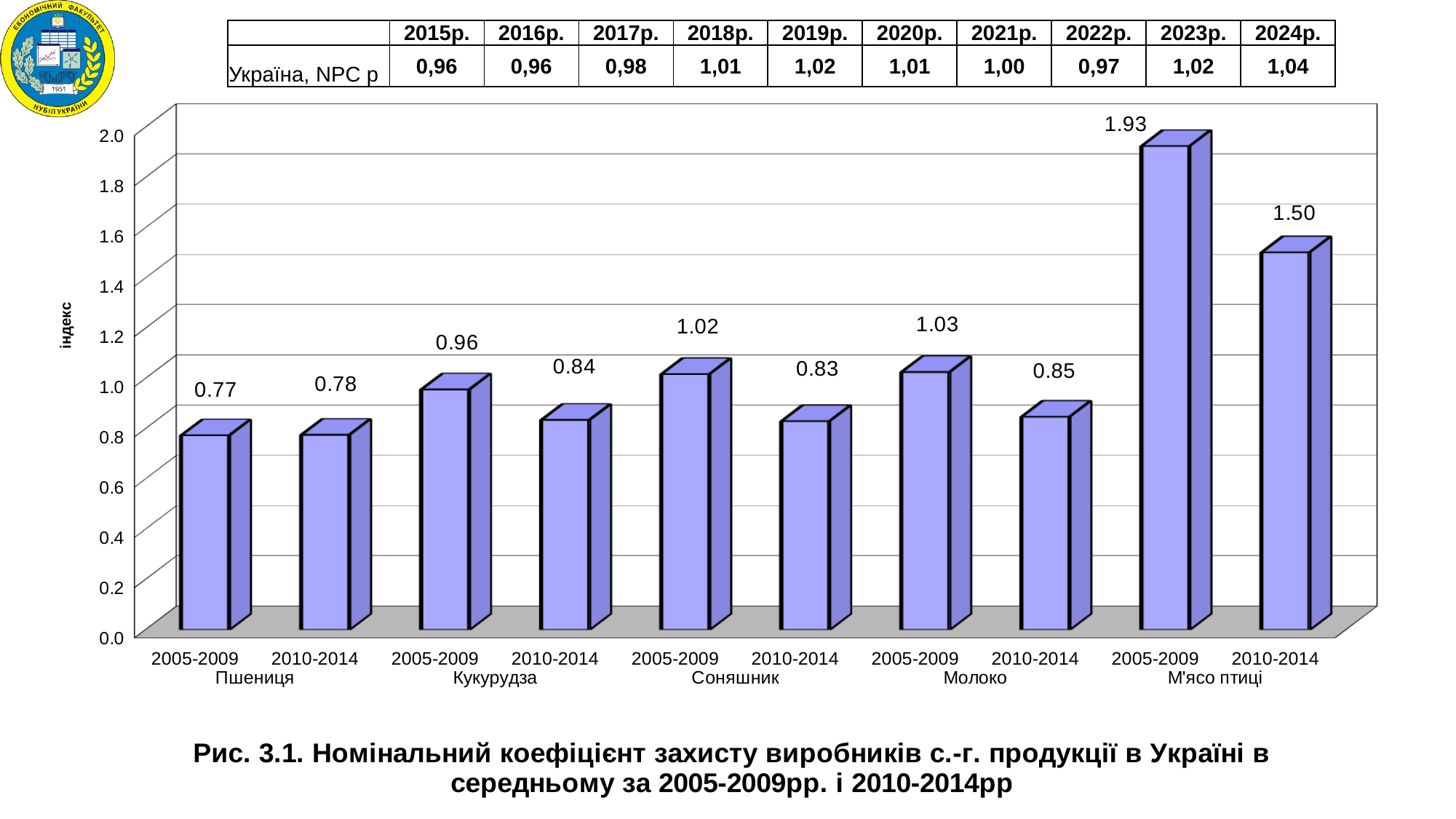
What is the difference between the М'ясо птиці values for 2005-2009 and 2010-2014? 0.43 Which bar has the highest value? М'ясо птиці 2005-2009 What is the value for Пшениця in 2005-2009? 0.77 Which is larger: Соняшник 2005-2009 or Соняшник 2010-2014? Соняшник 2005-2009 What is the label of the vertical axis? індекс How many bars are plotted in the chart? 10 What is the value for М'ясо птиці in 2010-2014? 1.50 What type of chart is shown? Bar chart Which bar has the lowest value? Пшениця 2005-2009 What is the difference between the Кукурудза values for 2005-2009 and 2010-2014? 0.12 What is the value for Молоко in 2010-2014? 0.85 What is the value for Соняшник in 2005-2009? 1.02